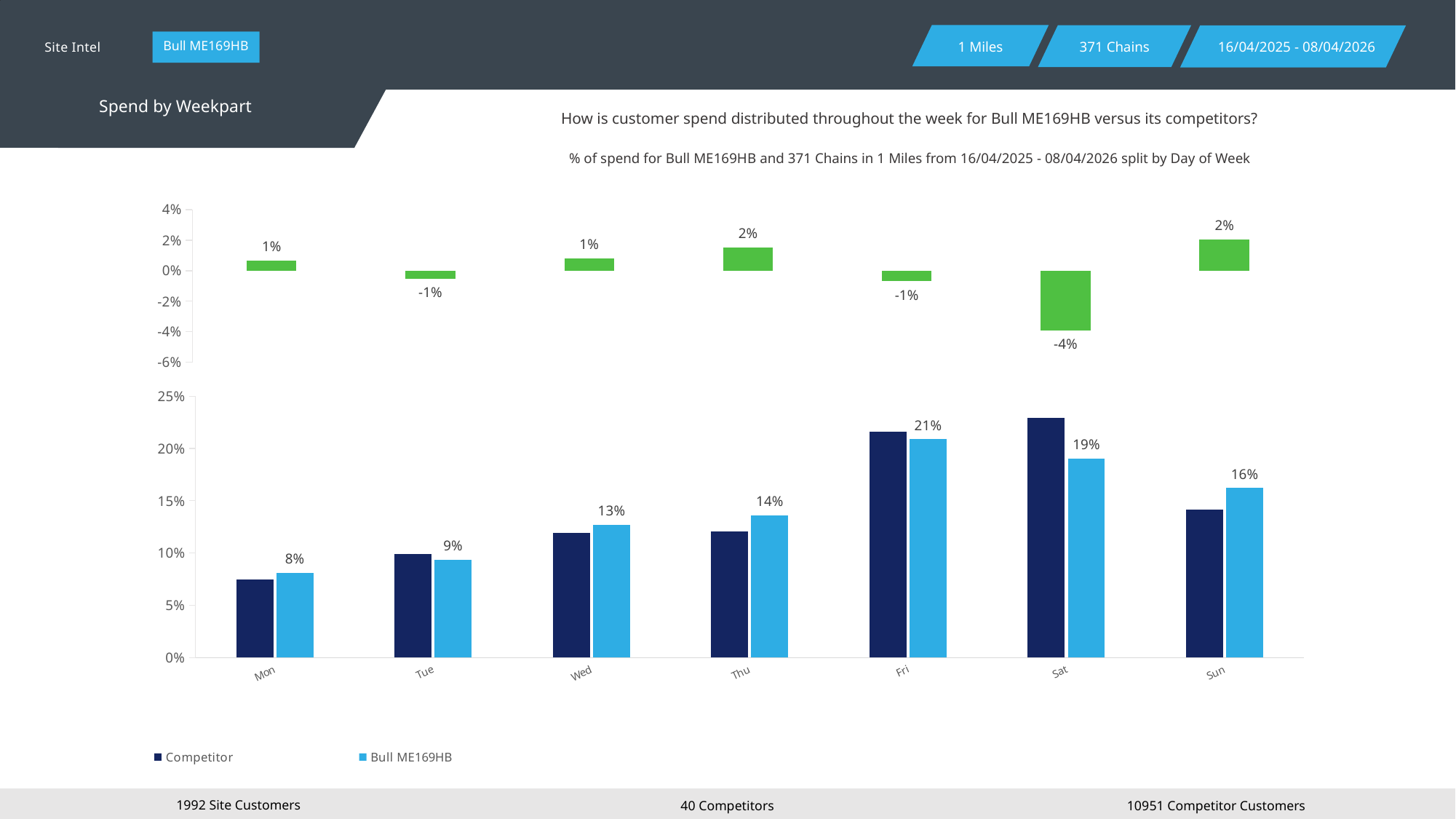
In the bottom chart, what is the difference between the Bull ME169HB values for Fri and Mon? 13% In the bottom chart, is the Competitor value for Sat greater or less than 20%? greater In the top chart, which day has the lowest value? Sat In the bottom chart, how many days of the week are shown on the x axis? 7 In the bottom chart, on Sat, which is larger: the Competitor bar or the Bull ME169HB bar? Competitor What type of chart is the bottom chart? Bar chart In the bottom chart, is the Competitor value for Mon greater or less than 10%? less In the top chart, what is the value shown for Sat? -4% In the bottom chart, what is the value for Bull ME169HB on Fri? 21% How many series does the legend of the bottom chart list? 2 In the bottom chart, on which day is the Bull ME169HB value highest? Fri In the bottom chart, on which day is the Bull ME169HB value lowest? Mon